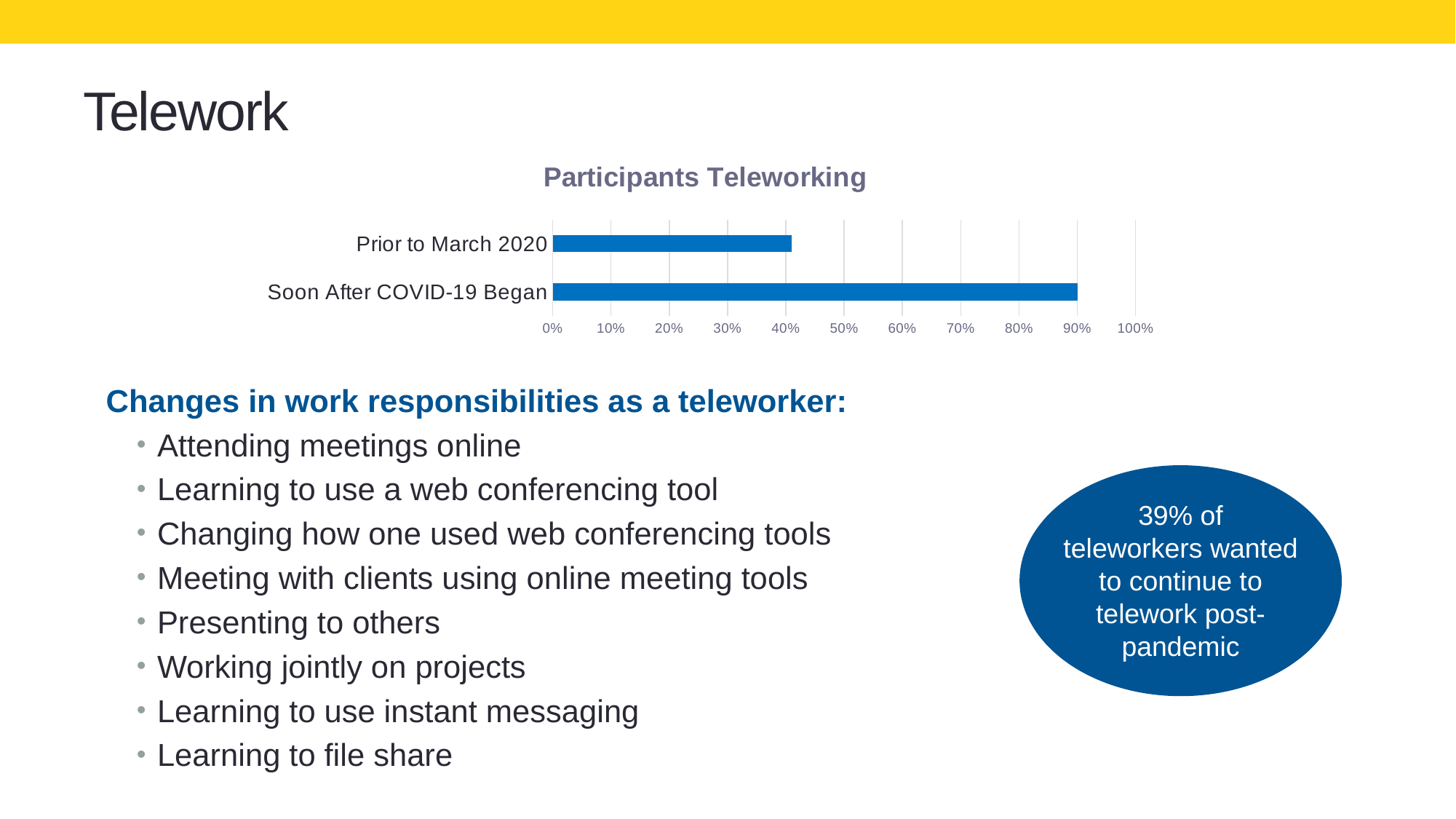
What kind of chart is shown under the title "Participants Teleworking"? bar chart In the "Participants Teleworking" chart, is the value for Soon After COVID-19 Began greater or less than 80%? greater In the "Participants Teleworking" chart, is the value for Soon After COVID-19 Began greater or less than 100%? less Which category in the "Participants Teleworking" chart has the highest value? Soon After COVID-19 Began Which category in the "Participants Teleworking" chart has the lowest value? Prior to March 2020 What is the highest value shown on the horizontal axis of the "Participants Teleworking" chart? 100% What is the title of the chart on the slide? Participants Teleworking In the "Participants Teleworking" chart, which is larger: the value for Prior to March 2020 or the value for Soon After COVID-19 Began? Soon After COVID-19 Began In the "Participants Teleworking" chart, is the value for Prior to March 2020 greater or less than 50%? less How many categories does the "Participants Teleworking" chart show? 2